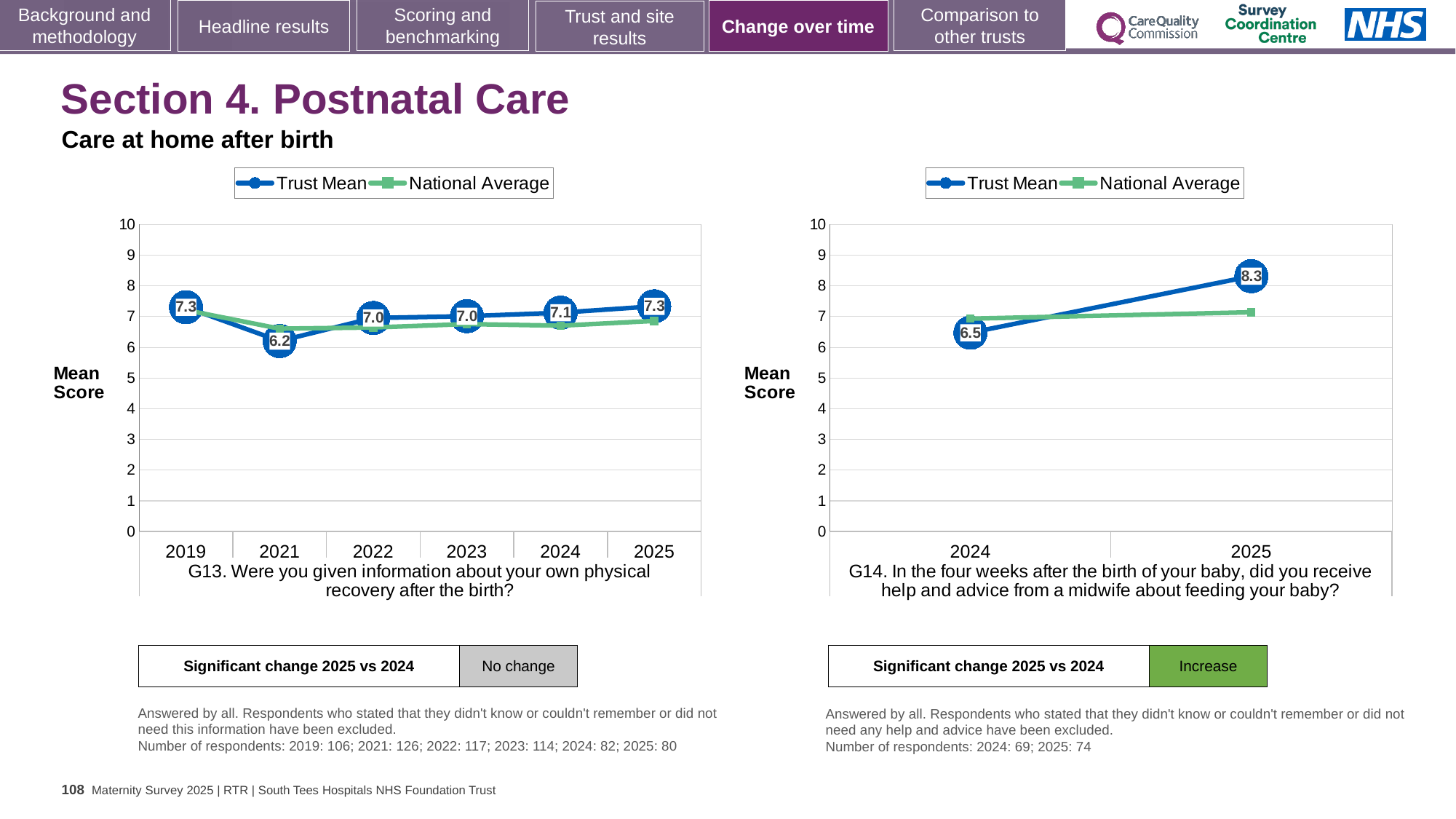
On the G13 chart (left), what is the Trust Mean score for 2021? 6.2 On the G14 chart (right), what is the Trust Mean score for 2025? 8.3 On the G13 chart (left), which year has the lowest Trust Mean score? 2021 On the G14 chart (right), what is the Trust Mean score for 2024? 6.5 On the G13 chart (left), what is the Trust Mean score for 2025? 7.3 On the G13 chart (left), how many years are shown on the x axis? 6 On the G13 chart (left), what is the difference between the Trust Mean scores for 2025 and 2021? 1.1 How many series does the legend of the G14 chart (right) list? 2 On the G14 chart (right), is the National Average for 2025 greater or less than 8? less On the G14 chart (right), does the Trust Mean rise or fall from 2024 to 2025? rise On the G13 chart (left), is the Trust Mean score for 2021 greater or less than 7? less On the G14 chart (right), what is the difference between the Trust Mean scores for 2025 and 2024? 1.8